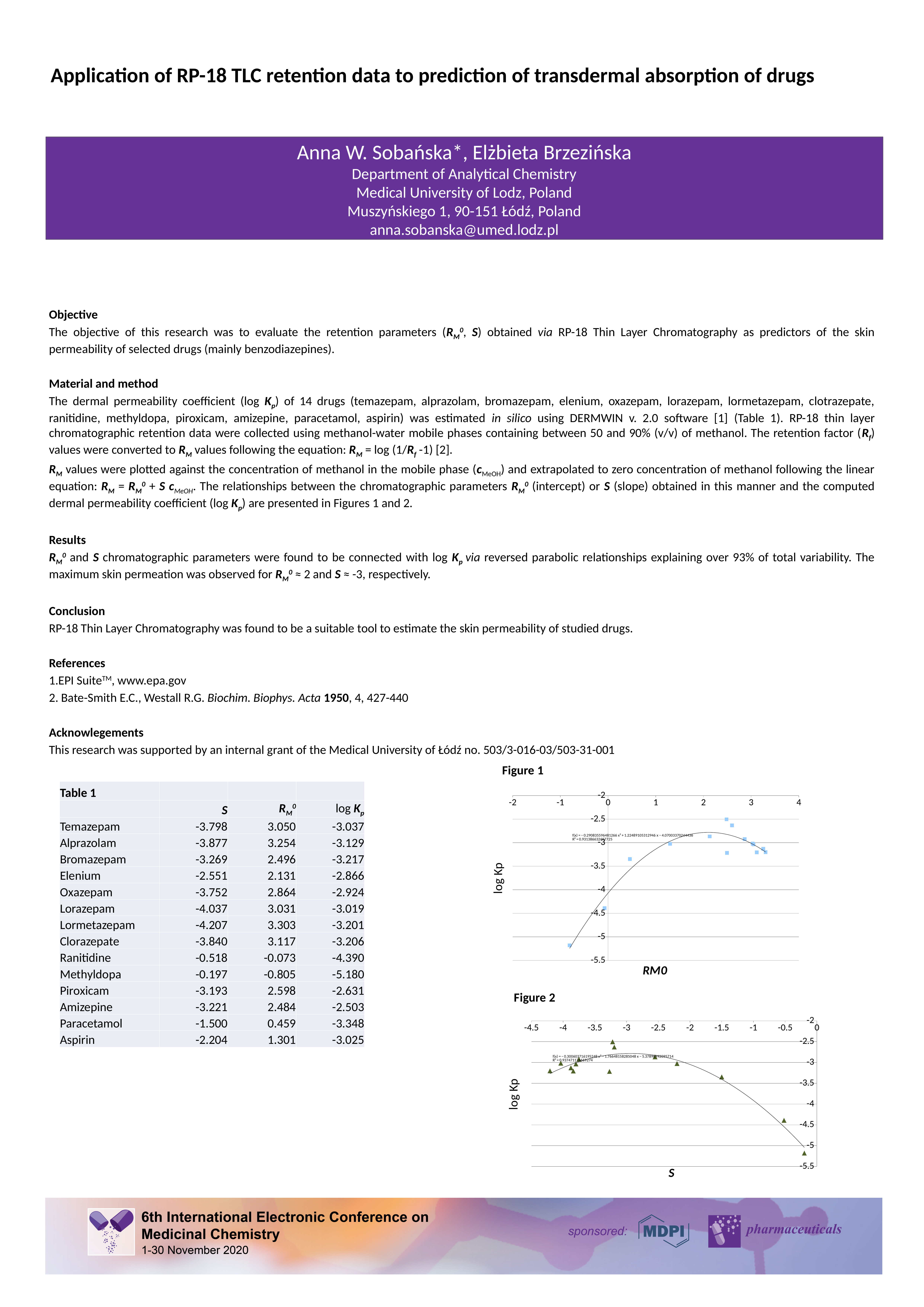
In Figure 2, do the log Kp values rise or fall as S increases from -1.5 to 0? fall In Figure 2, what is the label of the x axis? S What kind of chart is Figure 2? scatter chart In Figure 1, is the lowest plotted log Kp value greater or less than -5? less What kind of chart is Figure 1? scatter chart In Figure 2, is the highest plotted log Kp value greater or less than -3? greater In Figure 1, is the highest plotted log Kp value greater or less than -3? greater How many drugs (data points) are plotted in Figure 1? 14 How many drugs (data points) are plotted in Figure 2? 14 In Figure 1, what is the label of the x axis? RM0 In Figure 1, do the log Kp values rise or fall as RM0 increases from -1 to 2? rise